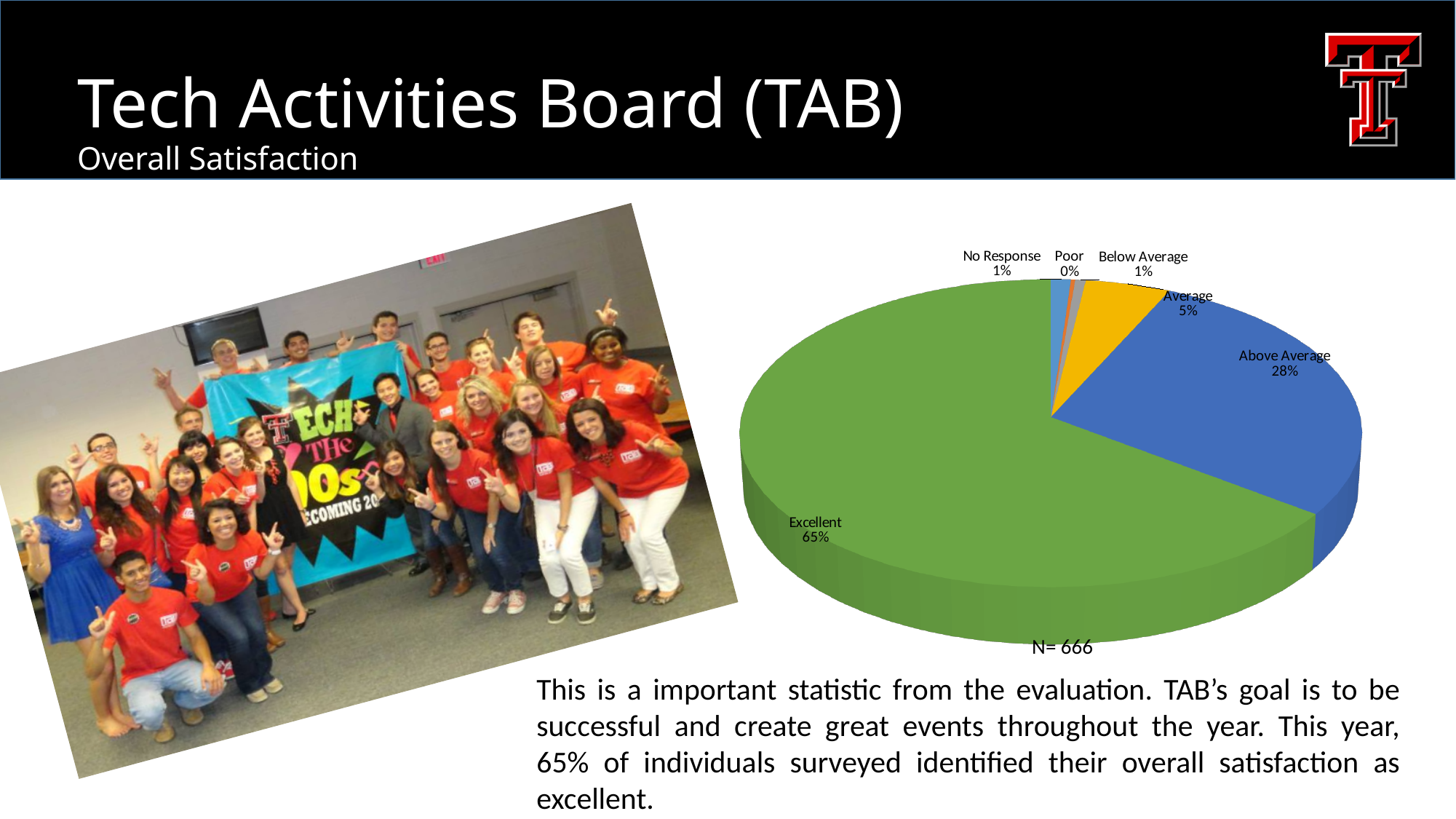
What percentage is shown for No Response? 1% What percentage is shown for Poor? 0% Which is larger, the Average slice or the Below Average slice? Average What is the difference in percentage points between Excellent and Above Average? 37 What sample size (N) is shown below the pie chart? N= 666 What share of the pie is labelled Excellent? 65% What percentage is shown for Average? 5% What kind of chart is shown on the slide? pie chart How many categories are labelled on the pie chart? 6 Which category has the smallest slice of the pie? Poor What percentage is shown for Above Average? 28% Which category has the largest slice of the pie? Excellent